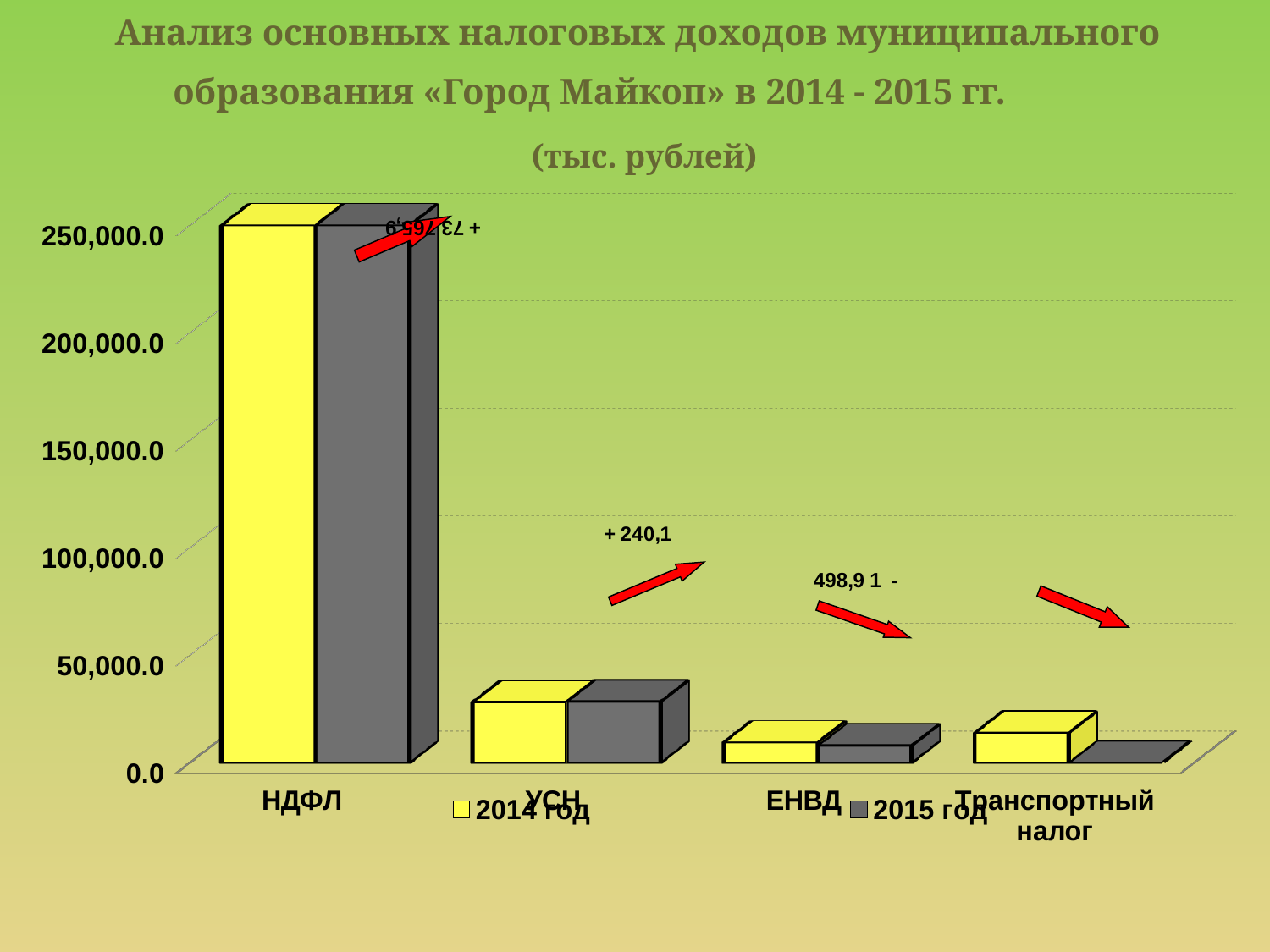
Is the value for ЕНВД in 2014 год greater or less than 50,000.0? less Which colour represents 2014 год in the legend? yellow Which is larger for 2015 год: НДФЛ or УСН? НДФЛ What change is annotated above the УСН bars? + 240,1 How many series does the legend list? 2 What kind of chart is shown on the slide? bar chart For Транспортный налог, which year has the larger value, 2014 год or 2015 год? 2014 год How many categories are shown on the x axis? 4 Is the value for УСН in 2015 год greater or less than 50,000.0? less Is the value for НДФЛ in 2014 год greater or less than 200,000.0? greater Which category has the lowest value for 2015 год? Транспортный налог Which category has the highest value for 2014 год? НДФЛ